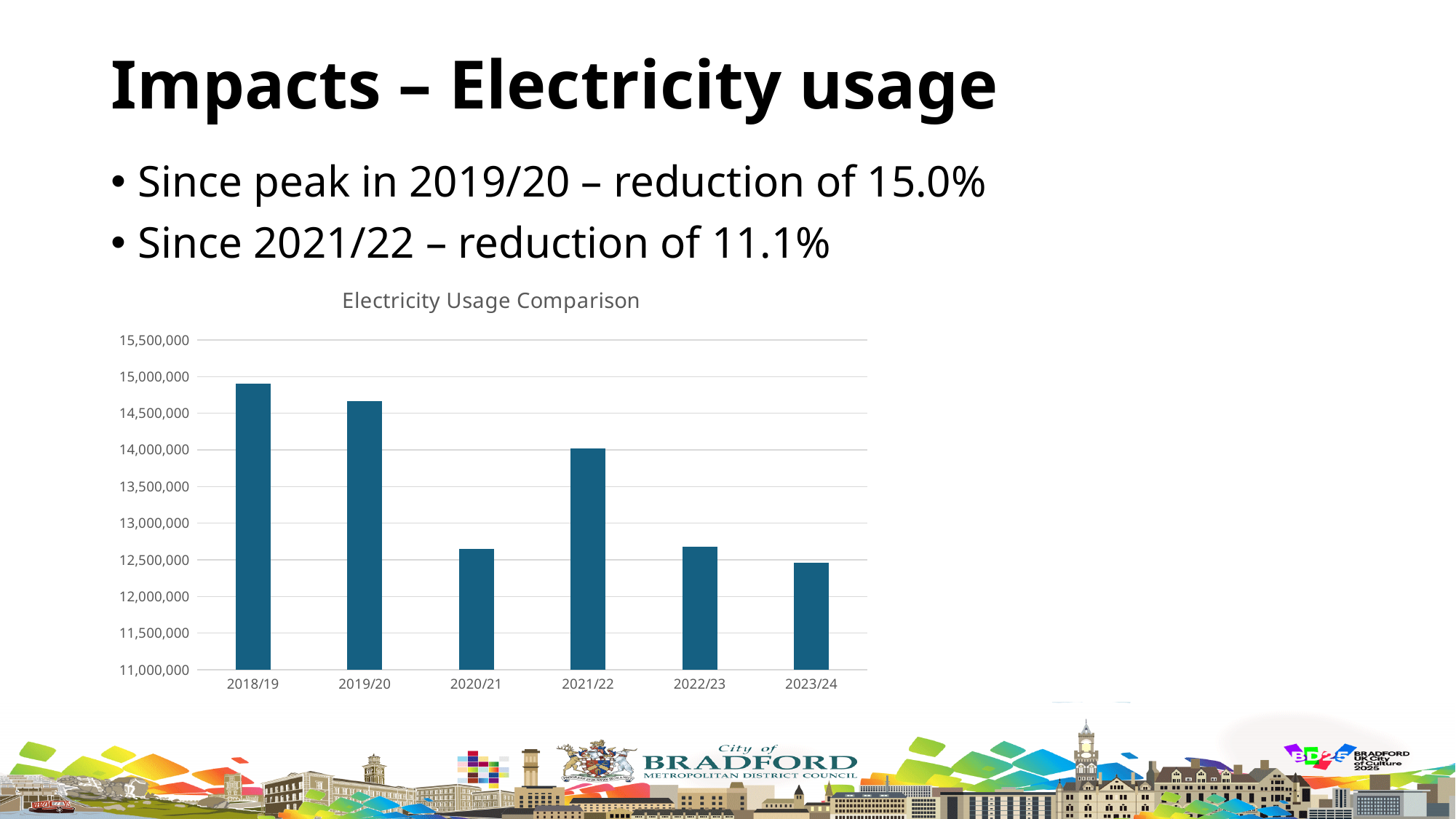
Which year has the lowest electricity usage on the chart? 2023/24 Which year has the highest electricity usage on the chart? 2018/19 Overall, do the values rise or fall from 2018/19 to 2023/24? fall How many years are plotted on the chart? 6 What is the title of the chart? Electricity Usage Comparison Is the value for 2020/21 greater or less than 12,000,000? greater Is the value for 2022/23 greater or less than 13,000,000? less Is the value for 2021/22 greater or less than 14,500,000? less Which is larger, the value for 2023/24 or the value for 2019/20? 2019/20 What type of chart is shown on the slide? Bar chart Which is larger, the value for 2021/22 or the value for 2020/21? 2021/22